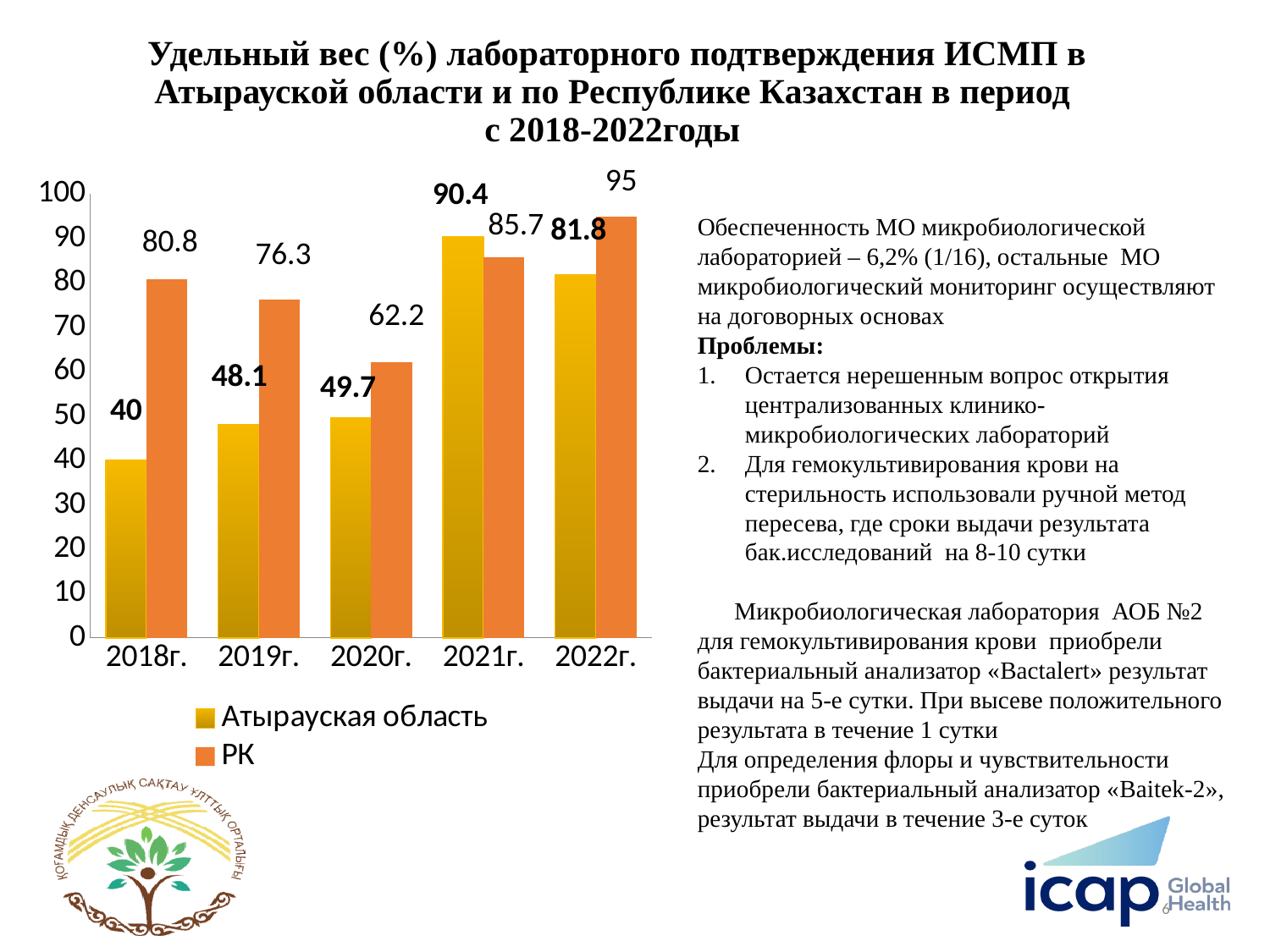
What is the value for Атырауская область in 2021г.? 90.4 What kind of chart is shown on the slide? bar chart In which year is the value for РК lowest? 2020г. In which year is the value for Атырауская область highest? 2021г. What is the value for Атырауская область in 2018г.? 40 What is the value for РК in 2022г.? 95 How many years are shown on the x axis? 5 What is the value for РК in 2020г.? 62.2 How many series does the legend list? 2 In 2021г., which series has the larger value, Атырауская область or РК? Атырауская область Is the value for Атырауская область in 2019г. greater or less than 50? less What is the difference between the РК value and the Атырауская область value in 2018г.? 40.8